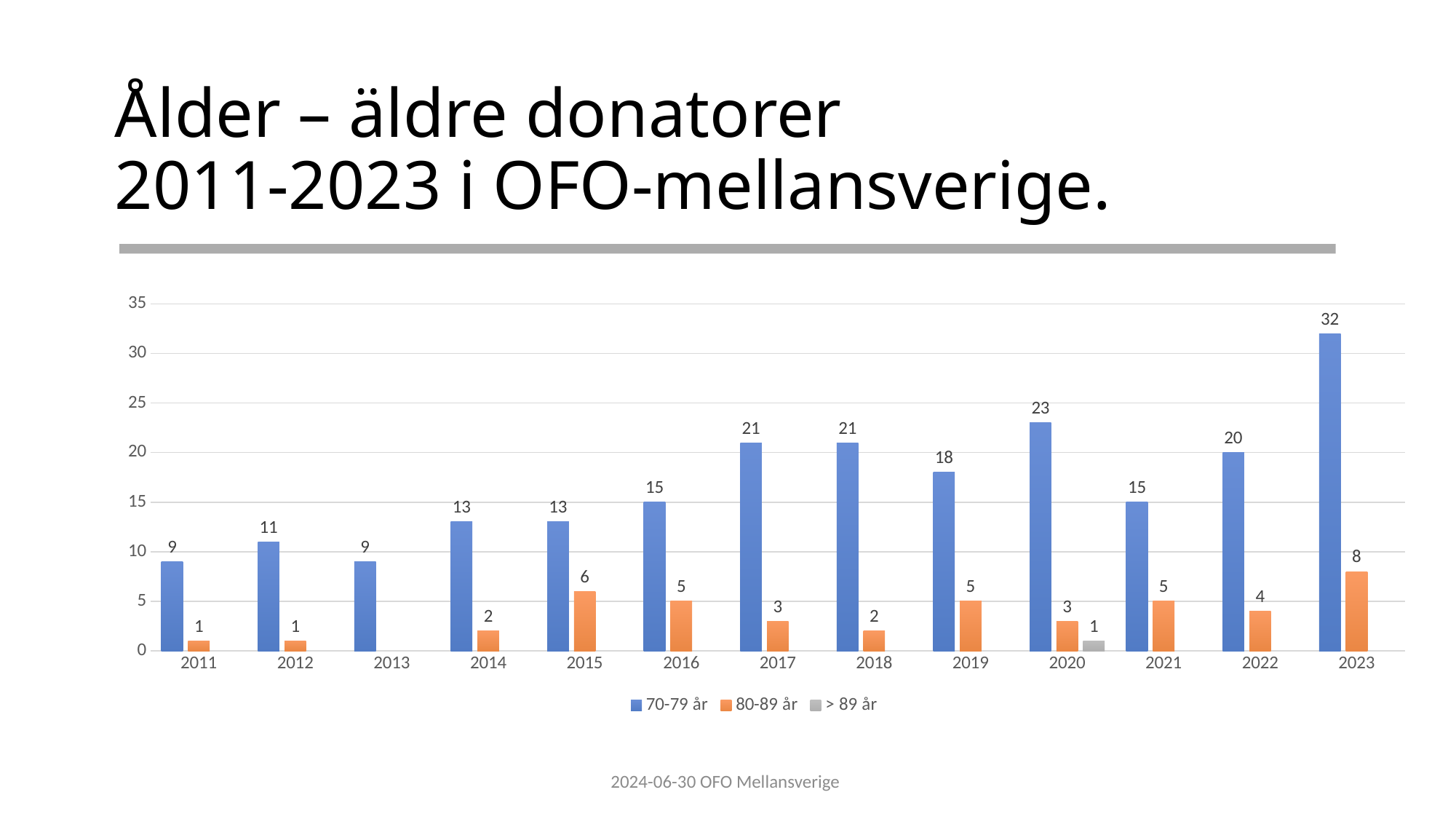
What is the value for the 70-79 år series in 2023? 32 Which colour represents the 80-89 år series? orange In which year is the 80-89 år series highest? 2023 How many years are shown on the x axis? 13 How many series does the legend list? 3 What is the difference between the 70-79 år values for 2023 and 2022? 12 What is the total of the 70-79 år and 80-89 år values for 2016? 20 In which year is the 70-79 år series highest? 2023 Which is larger, the 70-79 år value for 2019 or for 2020? 2020 What is the value for the > 89 år series in 2020? 1 What kind of chart is shown on the slide? bar chart What is the value for the 80-89 år series in 2015? 6